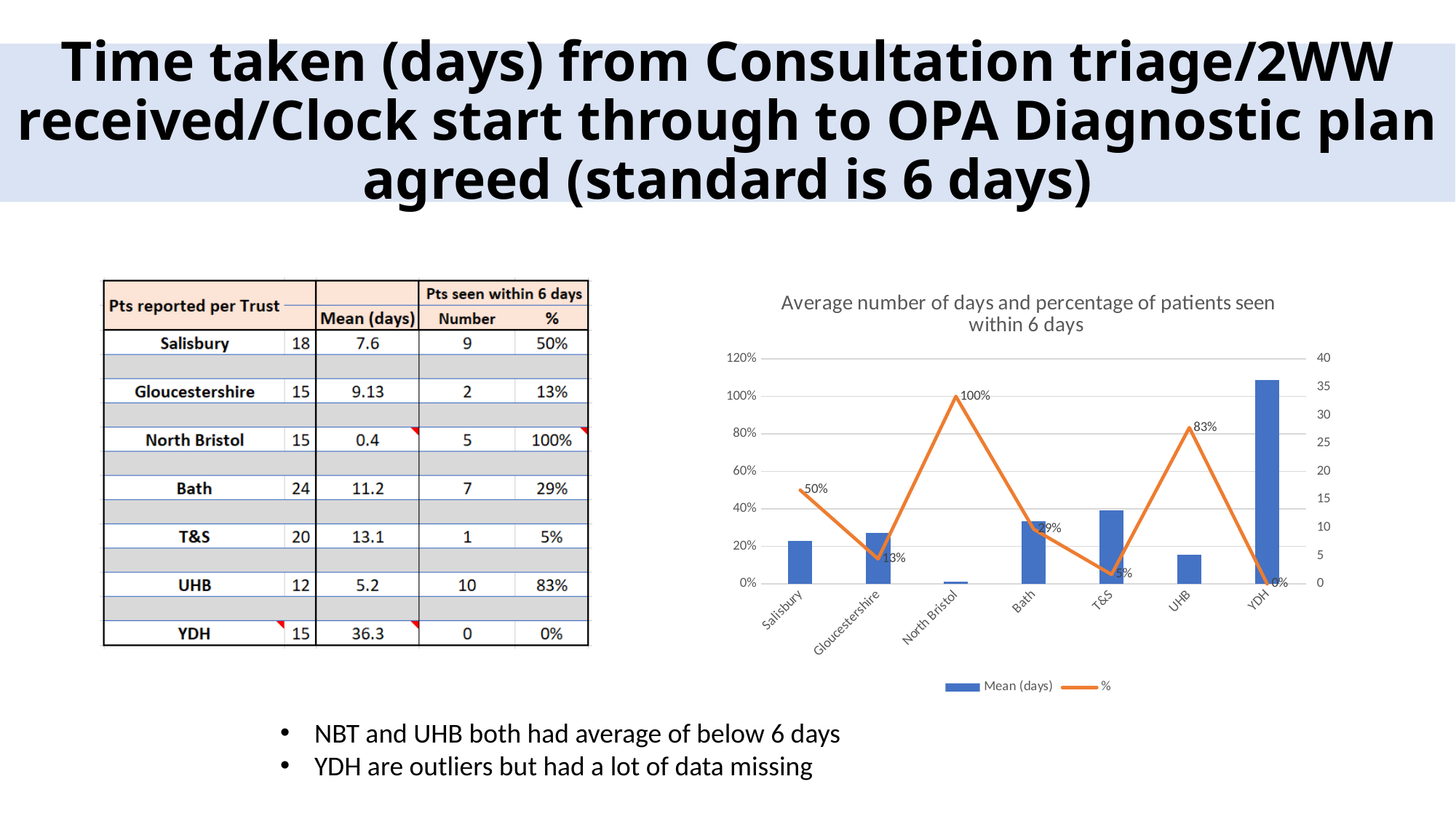
Which trust has the tallest Mean (days) bar in the chart? YDH Is the Mean (days) bar for UHB greater or less than 10 on the right-hand axis? less What percentage of patients were seen within 6 days at North Bristol according to the chart? 100% Which trust has the shortest Mean (days) bar in the chart? North Bristol What is the difference between the percentage for North Bristol and the percentage for UHB? 17% What percentage is shown for T&S on the chart? 5% Which trust has the lowest percentage of patients seen within 6 days in the chart? YDH What percentage value is labelled for UHB on the line in the chart? 83% How many series does the chart legend list? 2 Is the Mean (days) bar for YDH greater or less than 30 on the right-hand axis? greater Which has the taller Mean (days) bar, Bath or T&S? T&S Which trust has the highest percentage of patients seen within 6 days in the chart? North Bristol